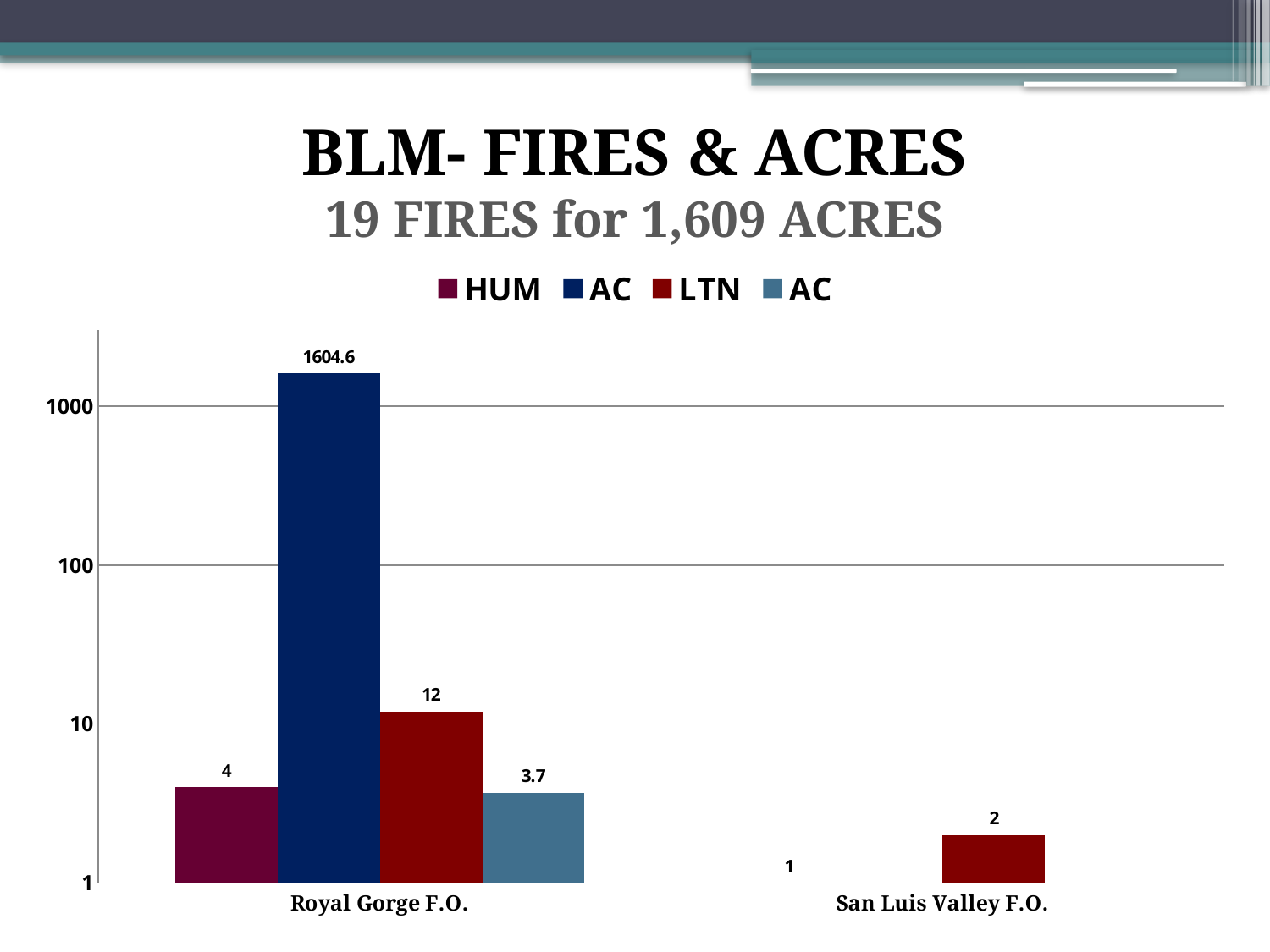
Which series has the highest value for Royal Gorge F.O.? AC (dark blue) What type of chart is shown on the slide? bar chart What is the difference between the LTN values for Royal Gorge F.O. and San Luis Valley F.O.? 10 How many series does the legend list? 4 How many categories are shown on the x axis? 2 What is the LTN value for Royal Gorge F.O.? 12 What is the value of the dark blue AC bar for Royal Gorge F.O.? 1604.6 What is the value of the light blue AC bar for Royal Gorge F.O.? 3.7 What is the HUM value for Royal Gorge F.O.? 4 What is the title of the chart on the slide? BLM- FIRES & ACRES What is the LTN value for San Luis Valley F.O.? 2 Is the LTN value for Royal Gorge F.O. greater or less than 10? greater